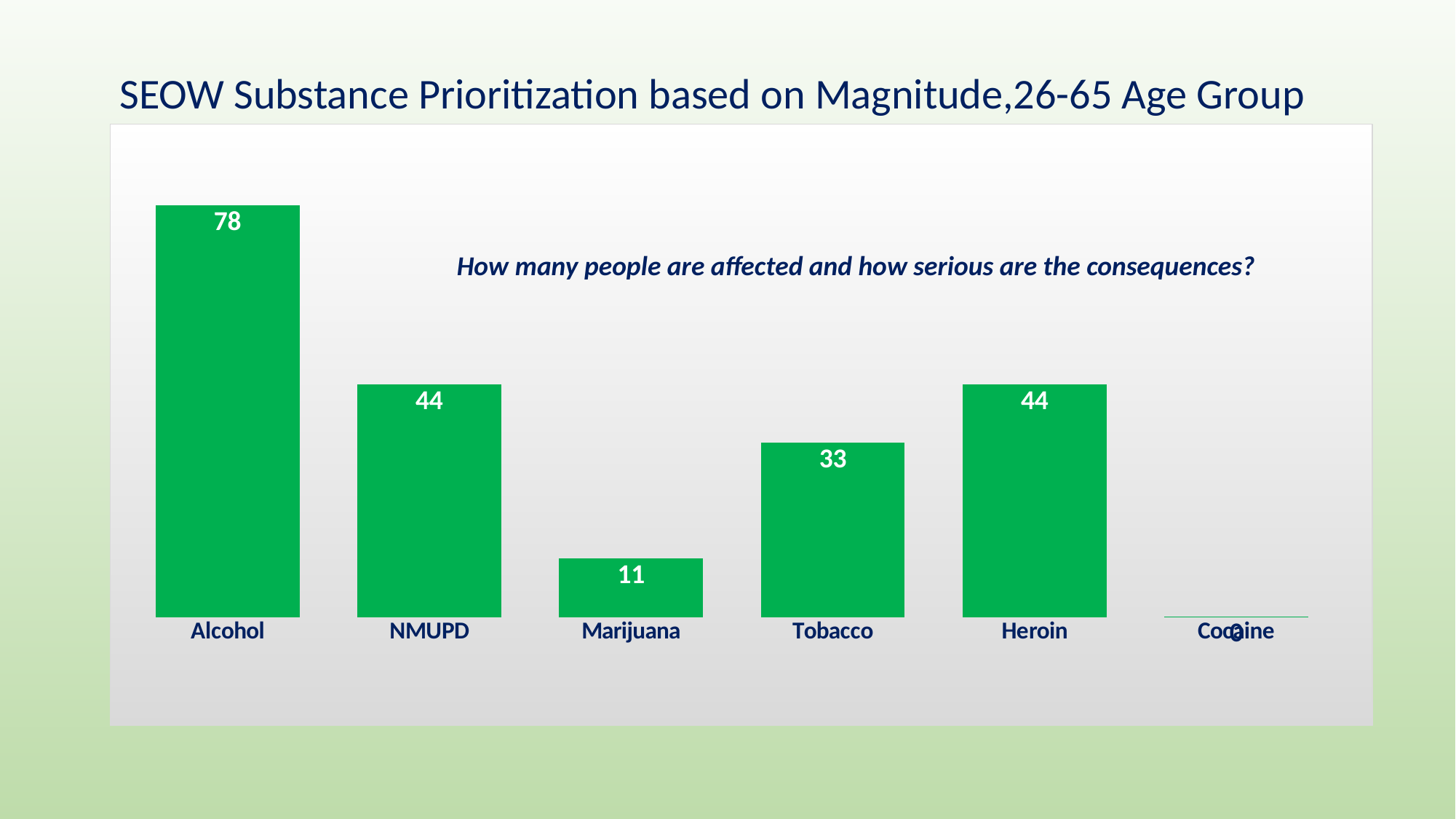
Which substance has the highest value? Alcohol What is the value for Marijuana? 11 What is the title of the slide? SEOW Substance Prioritization based on Magnitude,26-65 Age Group Which is larger, the value for Tobacco or the value for Marijuana? Tobacco What is the difference between the values for Tobacco and Marijuana? 22 What kind of chart is shown on the slide? Bar chart What is the difference between the values for Alcohol and NMUPD? 34 What is the value for NMUPD? 44 How many substances are shown on the chart? 6 What is the value for Tobacco? 33 Which substance has the lowest value? Cocaine What is the value for Alcohol? 78